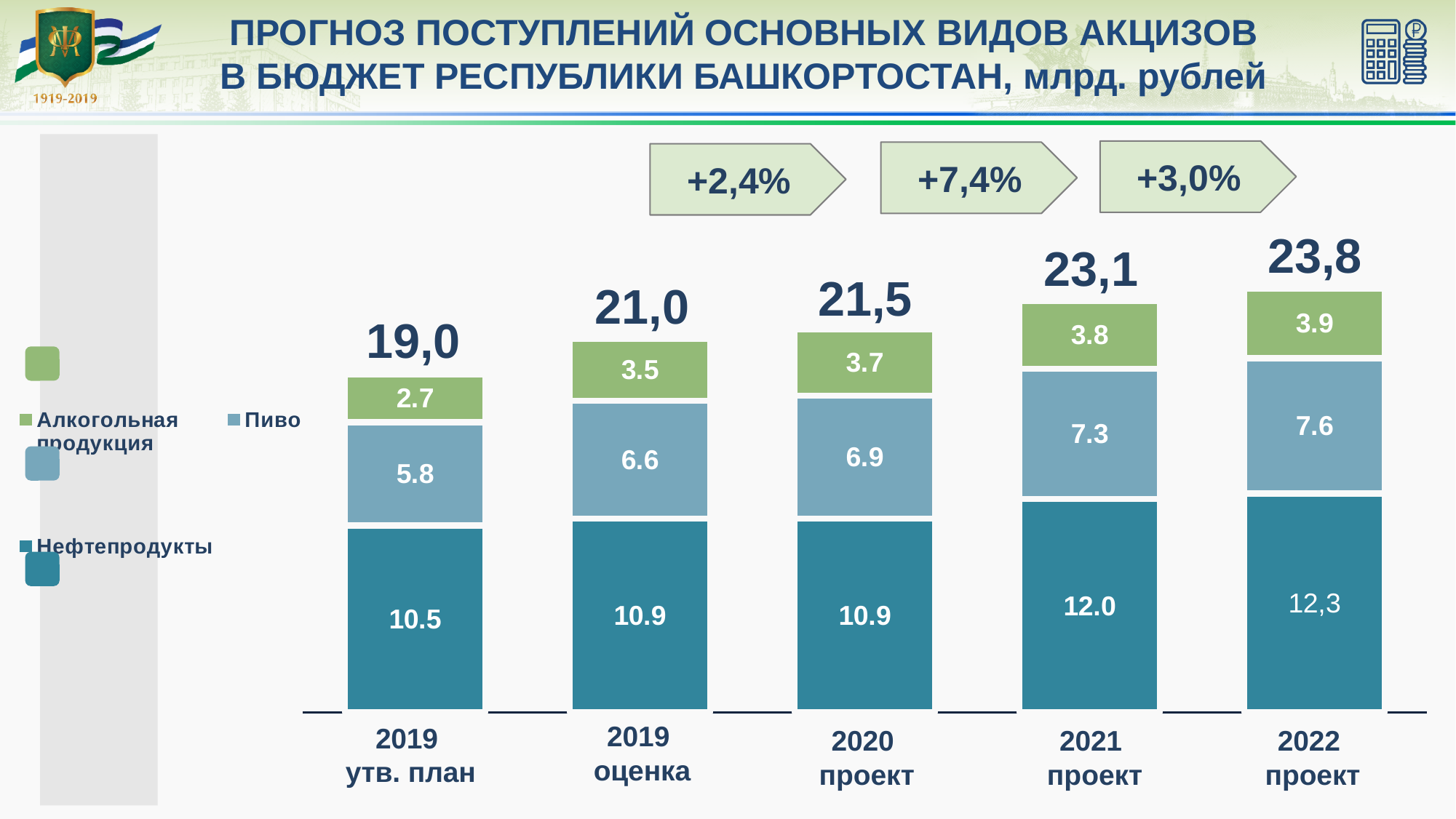
How many series does the legend list? 3 What is the total of the stacked bar for 2022 проект? 23,8 Which category has the lowest total? 2019 утв. план How many categories are shown along the x axis? 5 What is the value for Пиво in 2019 утв. план? 5.8 Which is larger: Алкогольная продукция in 2019 оценка or in 2019 утв. план? 2019 оценка Do the bar totals rise or fall from 2019 утв. план to 2022 проект? rise What type of chart is shown on the slide? stacked bar chart Which category has the highest value for Пиво? 2022 проект What is the difference between the Нефтепродукты values for 2021 проект and 2019 утв. план? 1.5 What is the value for Алкогольная продукция in 2020 проект? 3.7 What is the value for Нефтепродукты in 2021 проект? 12.0